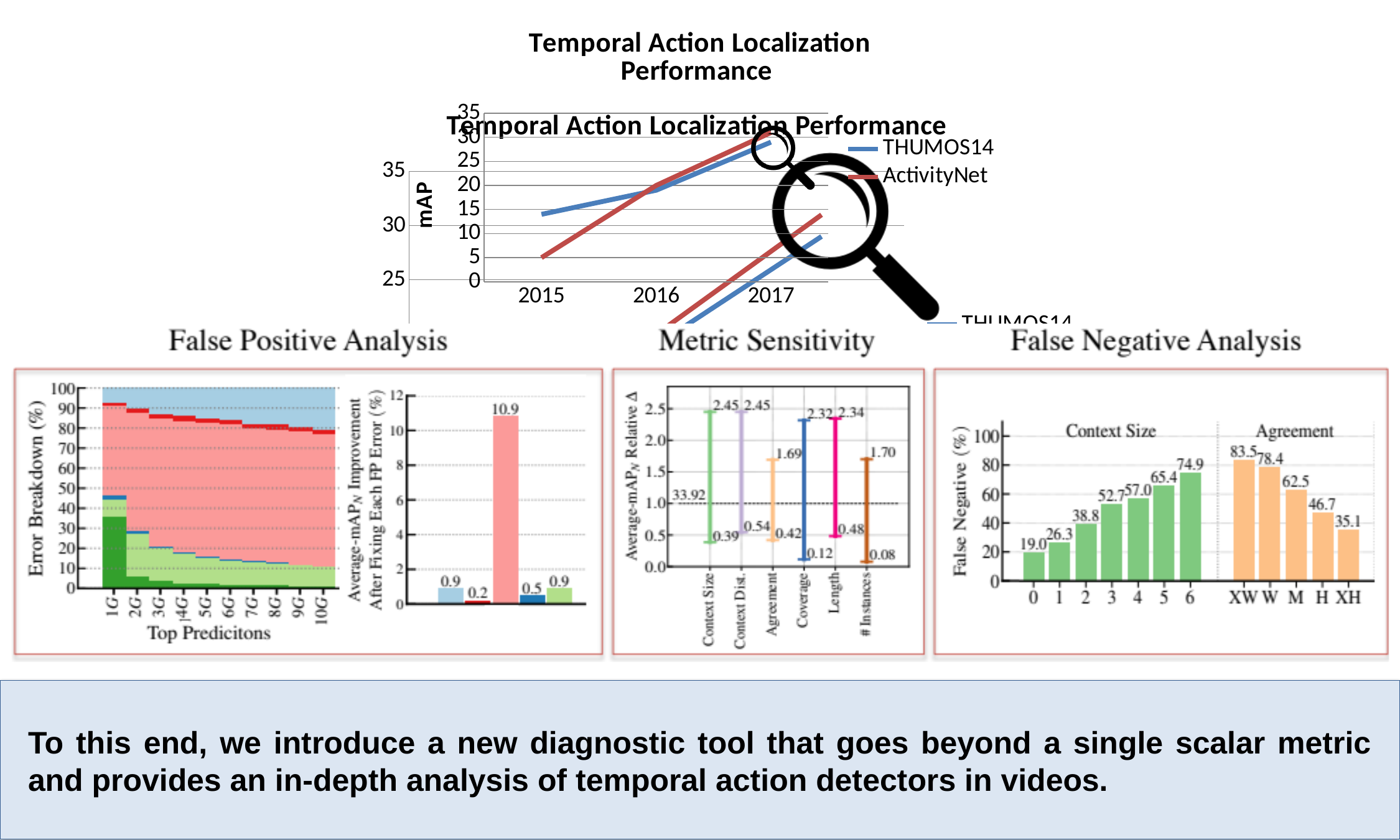
In the Temporal Action Localization Performance chart, does the THUMOS14 mAP rise or fall from 2015 to 2017? rise In the False Negative Analysis chart, which Agreement category has the lowest false negative value? XH In the Temporal Action Localization Performance chart, is the THUMOS14 value for 2017 greater or less than 25? greater In the Temporal Action Localization Performance chart, how many years are shown on the x axis? 3 In the Temporal Action Localization Performance chart, what kind of chart is it? line chart In the Temporal Action Localization Performance chart, how many series does the legend list? 2 In the Temporal Action Localization Performance chart, which series is drawn in red? ActivityNet In the False Positive Analysis chart, what is the largest Average-mAP improvement value shown on the bar chart? 10.9 In the Temporal Action Localization Performance chart, is the ActivityNet value for 2015 greater or less than 10? less In the Temporal Action Localization Performance chart, which series has the higher mAP in 2015, THUMOS14 or ActivityNet? THUMOS14 In the False Negative Analysis chart, what is the false negative value for context size 6? 74.9 In the False Negative Analysis chart, what is the difference between the false negative values for XW and XH? 48.4